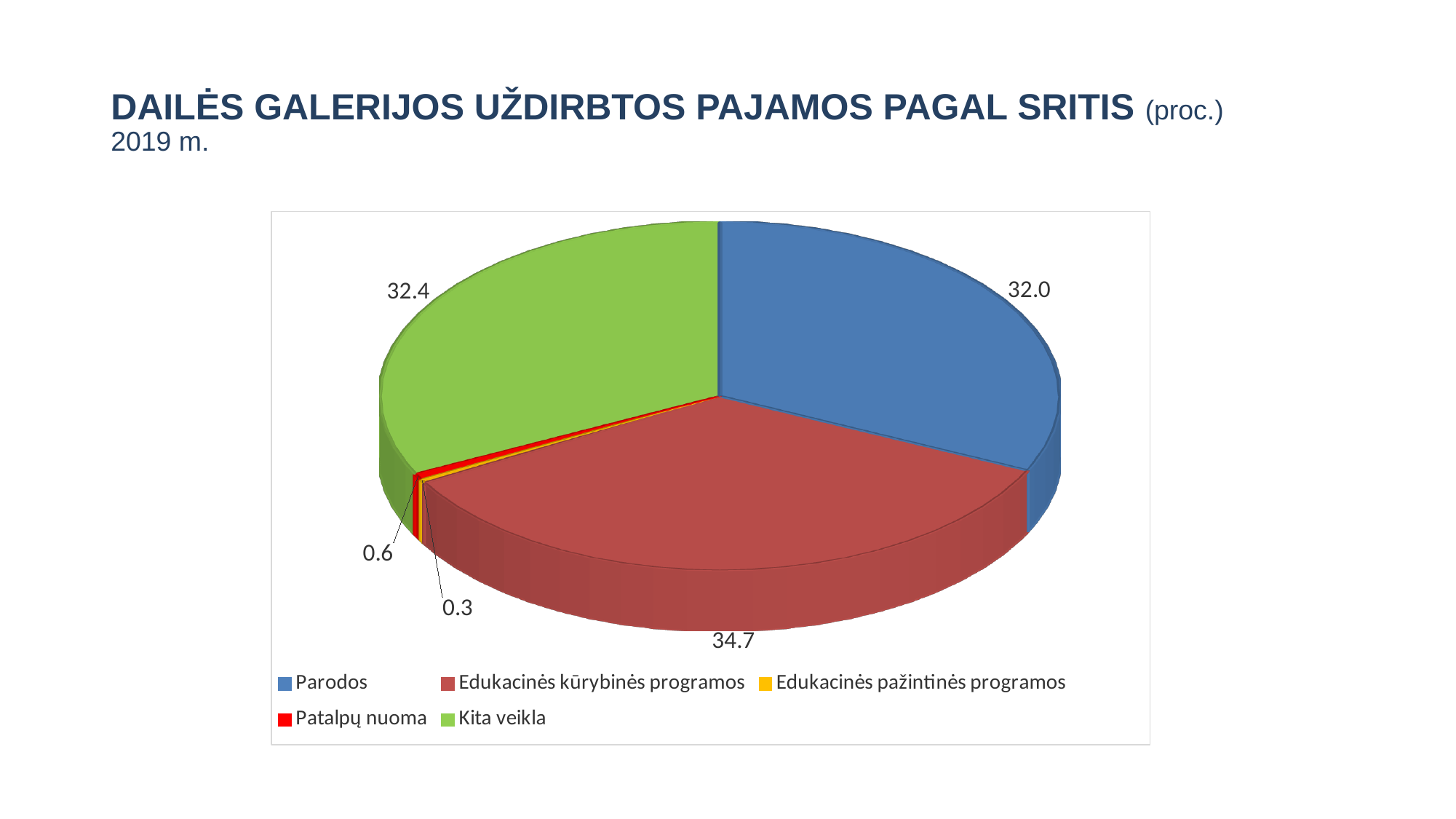
What kind of chart is shown on the slide? pie chart Which year does the chart title refer to? 2019 m. Which is larger, the value for Kita veikla or the value for Edukacinės kūrybinės programos? Edukacinės kūrybinės programos How many categories does the legend list? 5 What is the difference between the values for Edukacinės kūrybinės programos and Parodos? 2.7 What is the value for Patalpų nuoma? 0.6 What is the difference between the values for Kita veikla and Parodos? 0.4 What is the value for Edukacinės kūrybinės programos? 34.7 Which category has the largest share of the pie? Edukacinės kūrybinės programos What is the value for Parodos? 32.0 What is the value for Kita veikla? 32.4 Which category has the smallest share of the pie? Edukacinės pažintinės programos